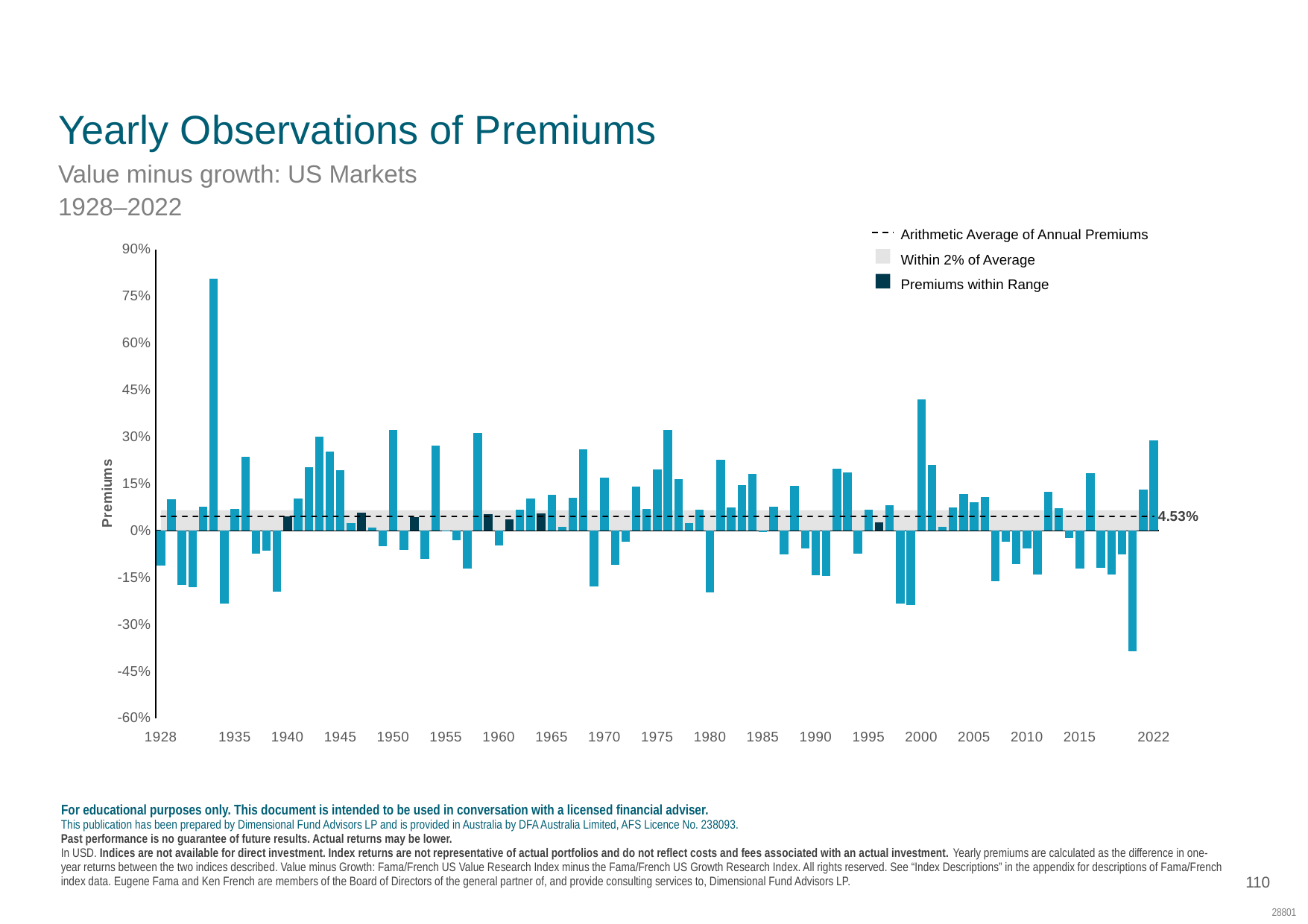
What does the dashed horizontal line on the chart represent? Arithmetic Average of Annual Premiums Is the value for 1980 greater or less than -15%? less Is the value for 2000 greater or less than 30%? greater Is the highest premium on the chart greater or less than 75%? greater What is the label on the vertical axis of the chart? Premiums Which year has the larger premium, 2000 or 2022? 2000 What is the arithmetic average of annual premiums shown on the chart? 4.53% How many entries does the chart legend list? 3 What kind of chart is shown on the slide? bar chart